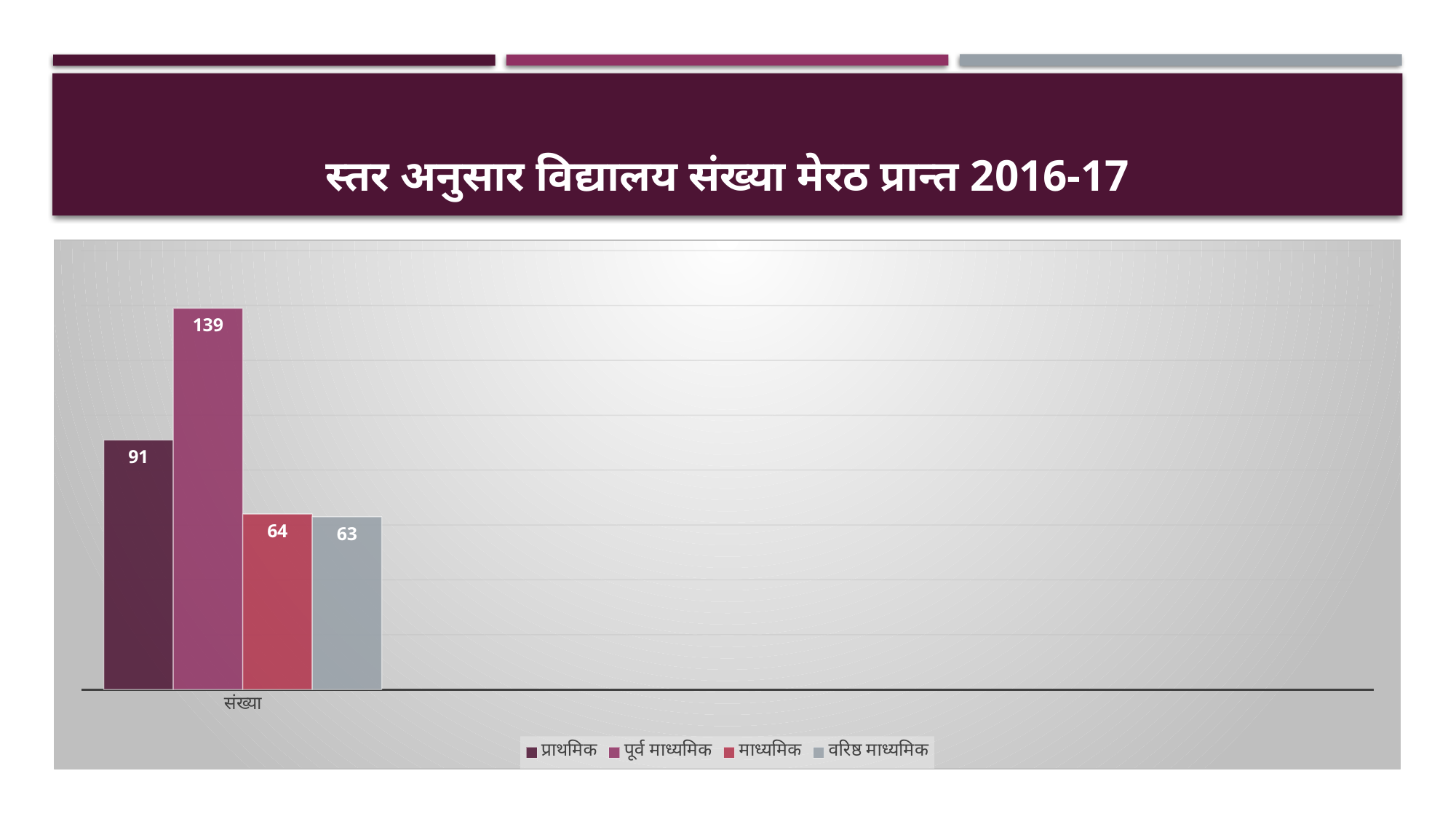
What kind of chart is shown on the slide? bar chart What is the value for पूर्व माध्यमिक? 139 What is the value for माध्यमिक? 64 What is the value for वरिष्ठ माध्यमिक? 63 What is the difference between the values for पूर्व माध्यमिक and प्राथमिक? 48 What is the value for प्राथमिक? 91 Which series has the highest value? पूर्व माध्यमिक Which series has the lowest value? वरिष्ठ माध्यमिक What is the difference between the values for प्राथमिक and माध्यमिक? 27 How many series does the legend list? 4 Which is larger, the value for प्राथमिक or the value for माध्यमिक? प्राथमिक What is the title of the slide? स्तर अनुसार विद्यालय संख्या मेरठ प्रान्त 2016-17